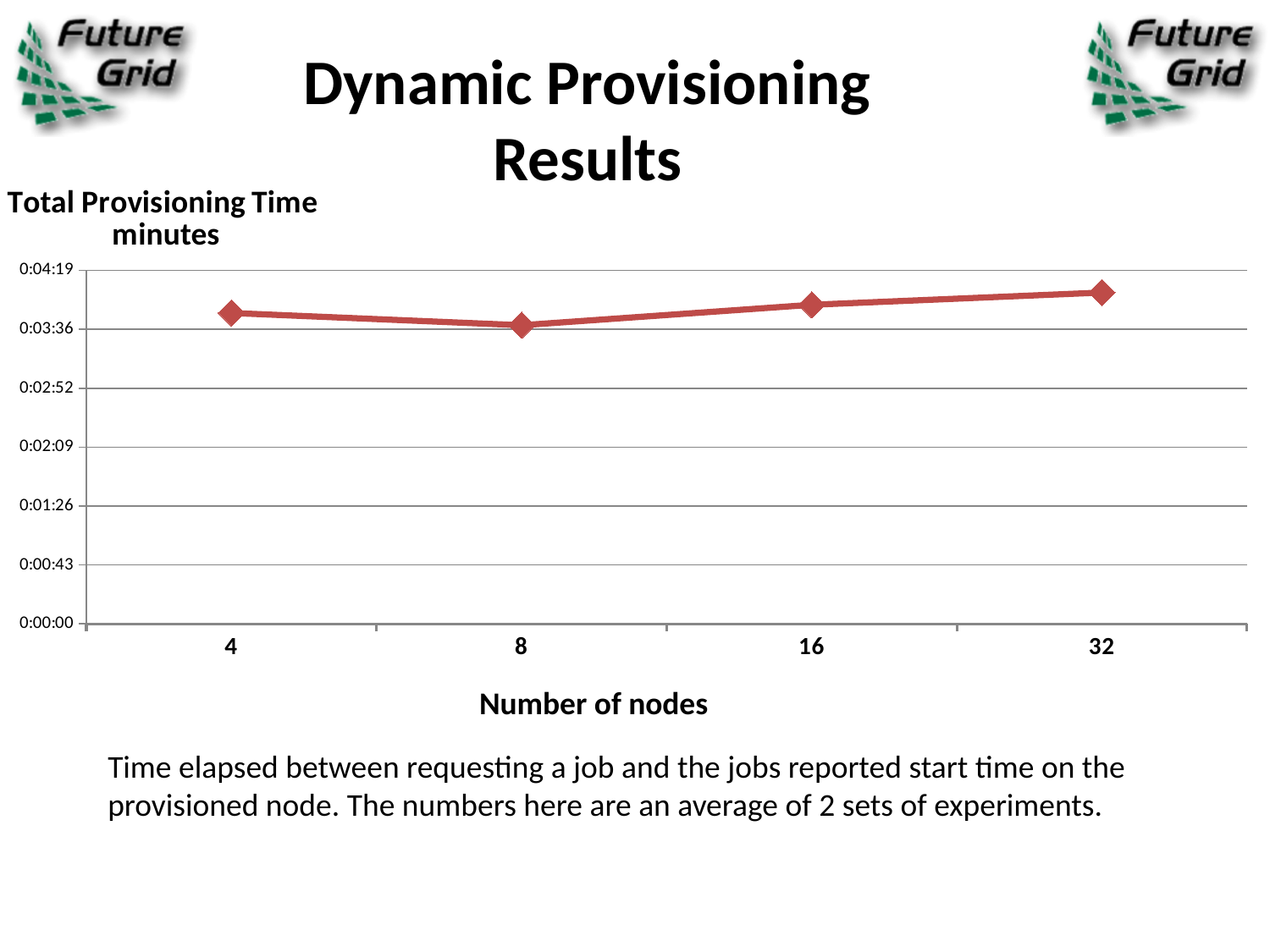
Which number of nodes has the lowest total provisioning time? 8 From 8 nodes to 32 nodes, does the total provisioning time rise or fall? rise What kind of chart is shown on the slide? line chart Which number of nodes has the highest total provisioning time? 32 Is the total provisioning time for 32 nodes greater or less than 0:04:19? less Is the total provisioning time for 4 nodes greater or less than 0:02:52? greater Which has the larger total provisioning time, 4 nodes or 8 nodes? 4 nodes What is the title of the chart? Total Provisioning Time minutes How many data points are plotted on the line? 4 What is the label of the x axis? Number of nodes Which has the larger total provisioning time, 16 nodes or 8 nodes? 16 nodes